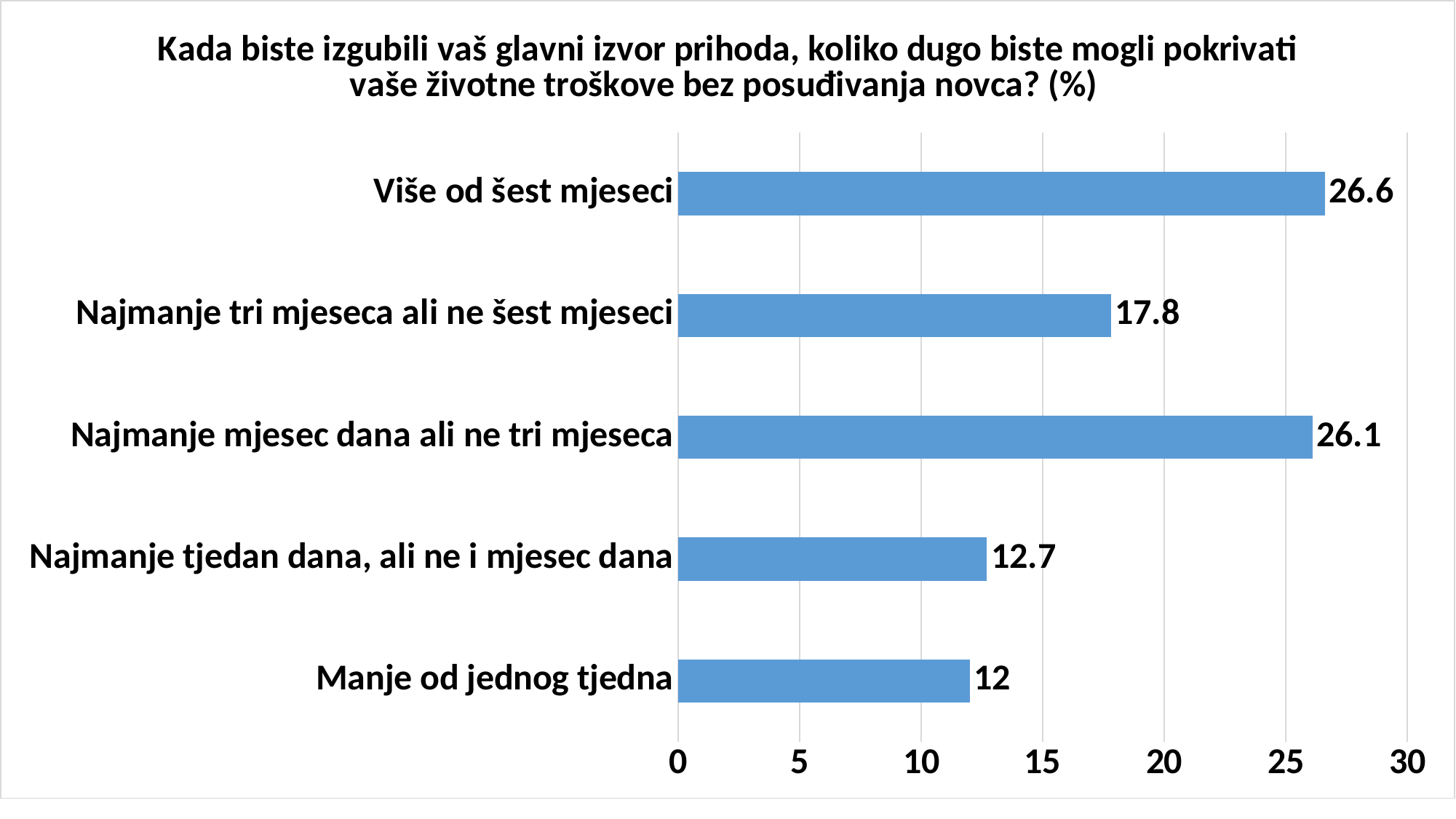
What is the maximum value shown on the horizontal axis? 30 What kind of chart is shown on the slide? Bar chart Which is larger, the value for "Najmanje mjesec dana ali ne tri mjeseca" or the value for "Najmanje tri mjeseca ali ne šest mjeseci"? Najmanje mjesec dana ali ne tri mjeseca Is the value for "Najmanje tri mjeseca ali ne šest mjeseci" greater or less than 20? less Which category has the highest value? Više od šest mjeseci What is the value for "Manje od jednog tjedna"? 12 What is the value for "Više od šest mjeseci"? 26.6 How many categories are shown in the chart? 5 What is the difference between the values for "Više od šest mjeseci" and "Najmanje tri mjeseca ali ne šest mjeseci"? 8.8 What is the value for "Najmanje tri mjeseca ali ne šest mjeseci"? 17.8 Which category has the lowest value? Manje od jednog tjedna What is the difference between the values for "Najmanje tjedan dana, ali ne i mjesec dana" and "Manje od jednog tjedna"? 0.7